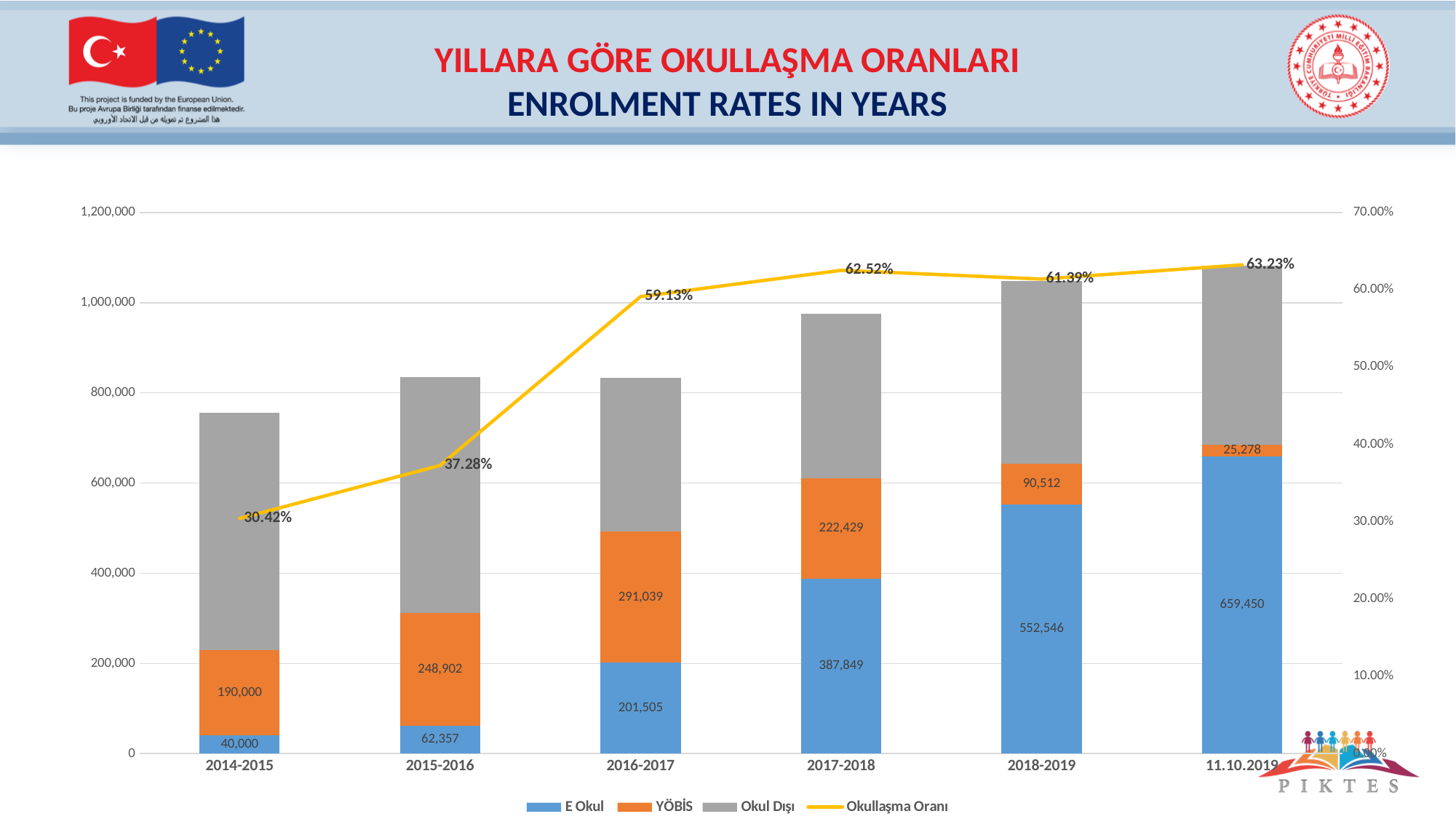
Which year has the lowest E Okul value? 2014-2015 How many year categories are shown on the x axis? 6 Is the Okullaşma Oranı for 2016-2017 greater or less than 50.00%? greater Which year has the highest Okullaşma Oranı? 11.10.2019 What is the Okullaşma Oranı for 2015-2016? 37.28% How many series does the legend list? 4 What is the E Okul value for 2017-2018? 387,849 What is the YÖBİS value for 2016-2017? 291,039 Which legend entry is shown as a yellow line? Okullaşma Oranı Which is larger, the YÖBİS value for 2015-2016 or for 2017-2018? 2015-2016 Does the E Okul value rise or fall from 2014-2015 to 11.10.2019? rise What is the difference between the E Okul values for 2018-2019 and 2017-2018? 164,697